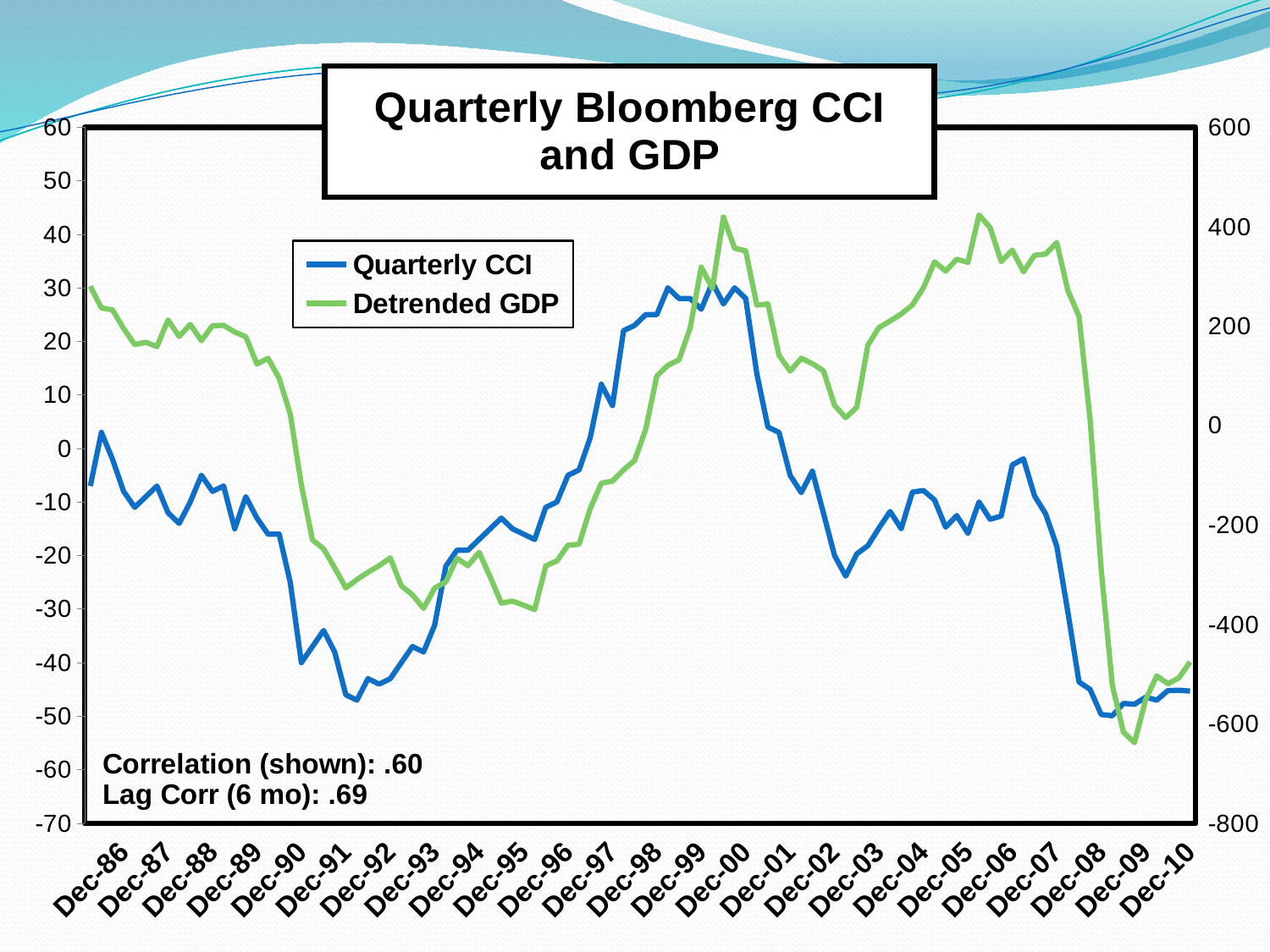
Is the Detrended GDP value at Dec-05 greater or less than 200? greater What kind of chart is shown on the slide? line chart Does the Quarterly CCI line rise or fall between Dec-07 and Dec-08? fall Is the Quarterly CCI value at Dec-91 greater or less than -40? less What is the highest value shown on the right-hand axis? 600 How many series does the legend list? 2 What is the title of the chart? Quarterly Bloomberg CCI and GDP How many date labels are shown along the x axis? 25 Is the Detrended GDP value at Dec-09 greater or less than -400? less What colour is the Quarterly CCI line? blue Does the Detrended GDP line rise or fall between Dec-07 and Dec-09? fall